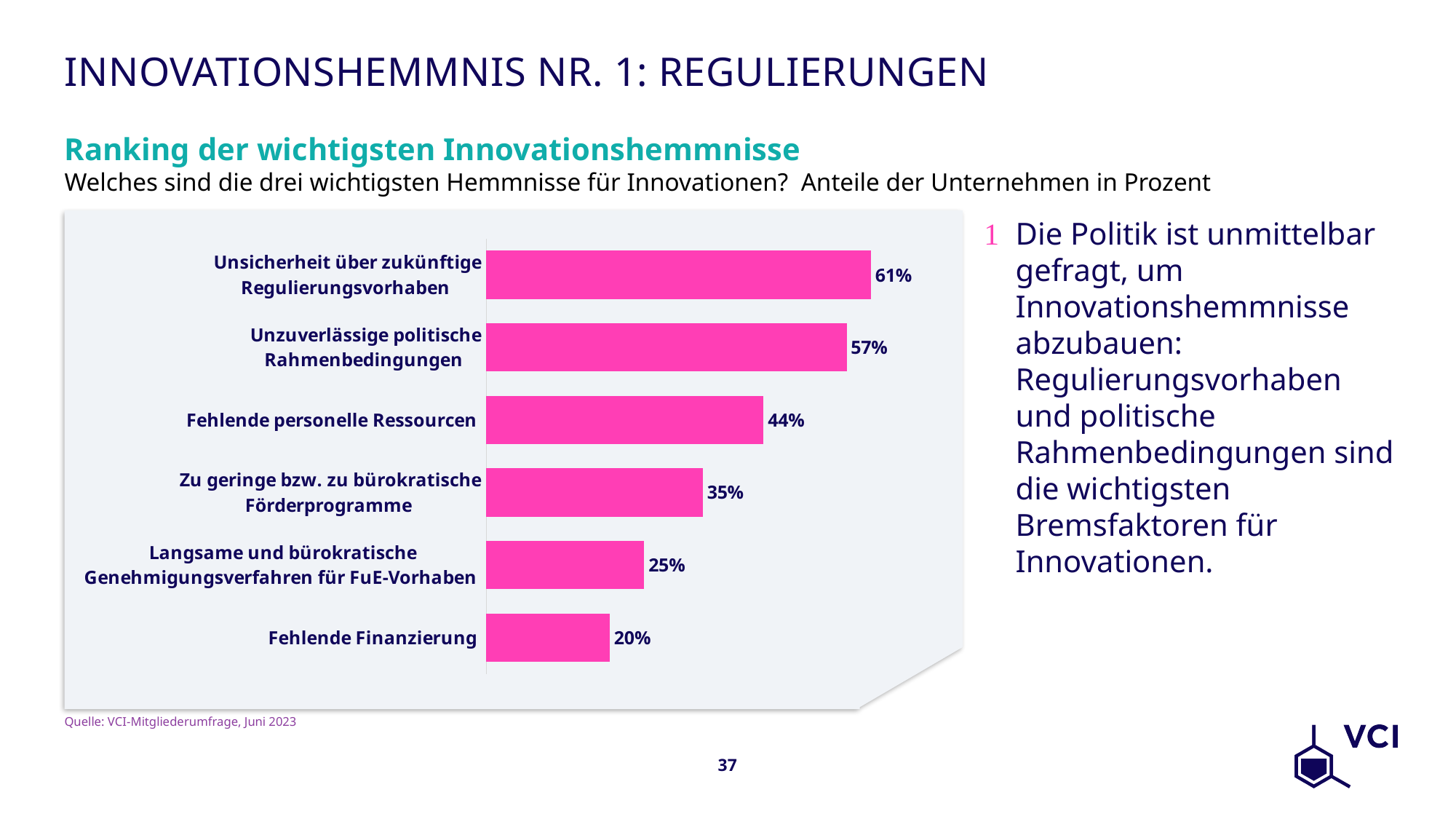
What is the value for "Fehlende personelle Ressourcen"? 44% What is the value for "Langsame und bürokratische Genehmigungsverfahren für FuE-Vorhaben"? 25% Which category has the lowest value? Fehlende Finanzierung What is the value for "Unsicherheit über zukünftige Regulierungsvorhaben"? 61% What is the value for "Fehlende Finanzierung"? 20% Which category has the highest value? Unsicherheit über zukünftige Regulierungsvorhaben What is the difference between the values for "Fehlende personelle Ressourcen" and "Fehlende Finanzierung"? 24 percentage points What kind of chart is shown on the slide? Bar chart What is the difference between the values for "Unsicherheit über zukünftige Regulierungsvorhaben" and "Unzuverlässige politische Rahmenbedingungen"? 4 percentage points How many categories are shown in the chart? 6 Which is larger: the value for "Zu geringe bzw. zu bürokratische Förderprogramme" or for "Langsame und bürokratische Genehmigungsverfahren für FuE-Vorhaben"? Zu geringe bzw. zu bürokratische Förderprogramme What is the source given below the chart? VCI-Mitgliederumfrage, Juni 2023